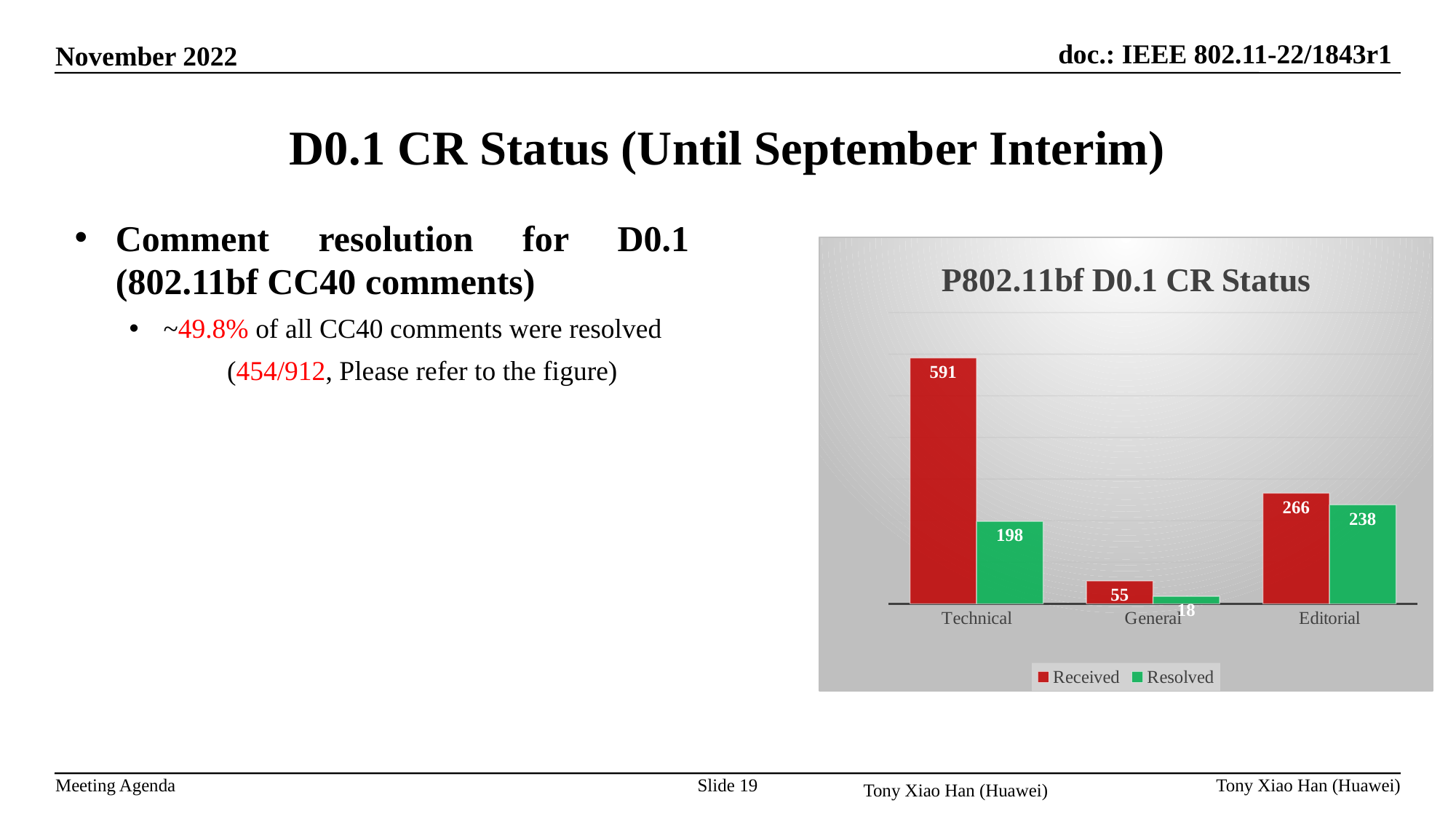
What kind of chart is shown on the slide? Bar chart Which category has the lowest number of Resolved comments? General What is the difference between Received and Resolved comments for Technical? 393 What is the number of Resolved comments for General? 18 How many series does the legend list? 2 What is the difference between Received and Resolved comments for Editorial? 28 What is the number of Resolved comments for Editorial? 238 Which is larger: Resolved comments for Technical or Resolved comments for Editorial? Editorial How many categories are shown on the x axis? 3 Which category has the highest number of Received comments? Technical What is the title of the chart? P802.11bf D0.1 CR Status What is the number of Received comments for Technical? 591